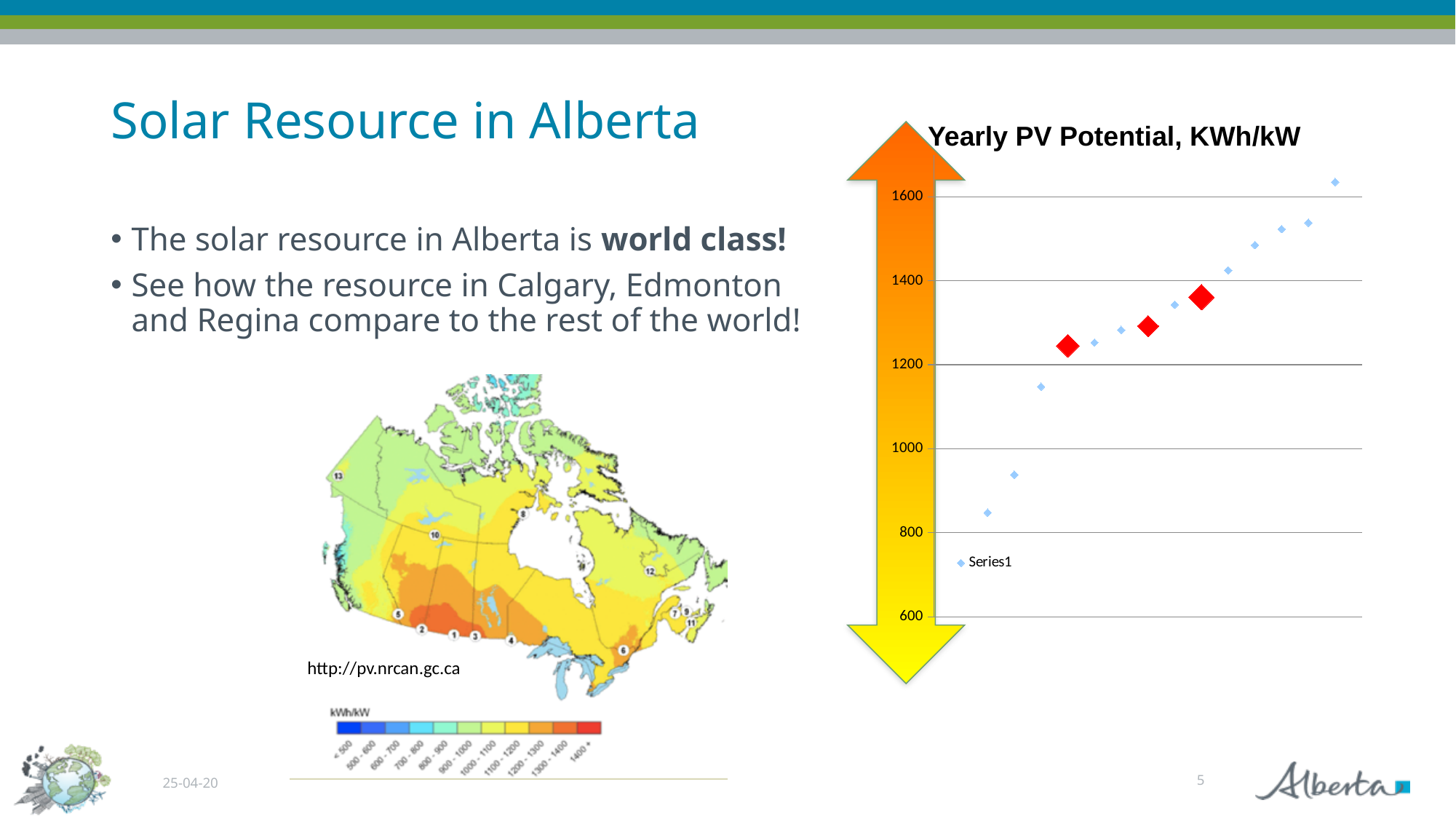
In the "Yearly PV Potential, KWh/kW" chart, are the three large red diamond points greater or less than 1200? greater How many large red diamond markers are plotted in the "Yearly PV Potential, KWh/kW" chart? 3 In the "Yearly PV Potential, KWh/kW" chart, are the three large red diamond points greater or less than 1400? less In the "Yearly PV Potential, KWh/kW" chart, is the highest plotted point greater or less than 1600? greater What is the title of the chart on the right of the slide? Yearly PV Potential, KWh/kW What kind of chart is the "Yearly PV Potential, KWh/kW" chart? scatter chart In the "Yearly PV Potential, KWh/kW" chart, do the plotted values rise or fall from left to right? rise